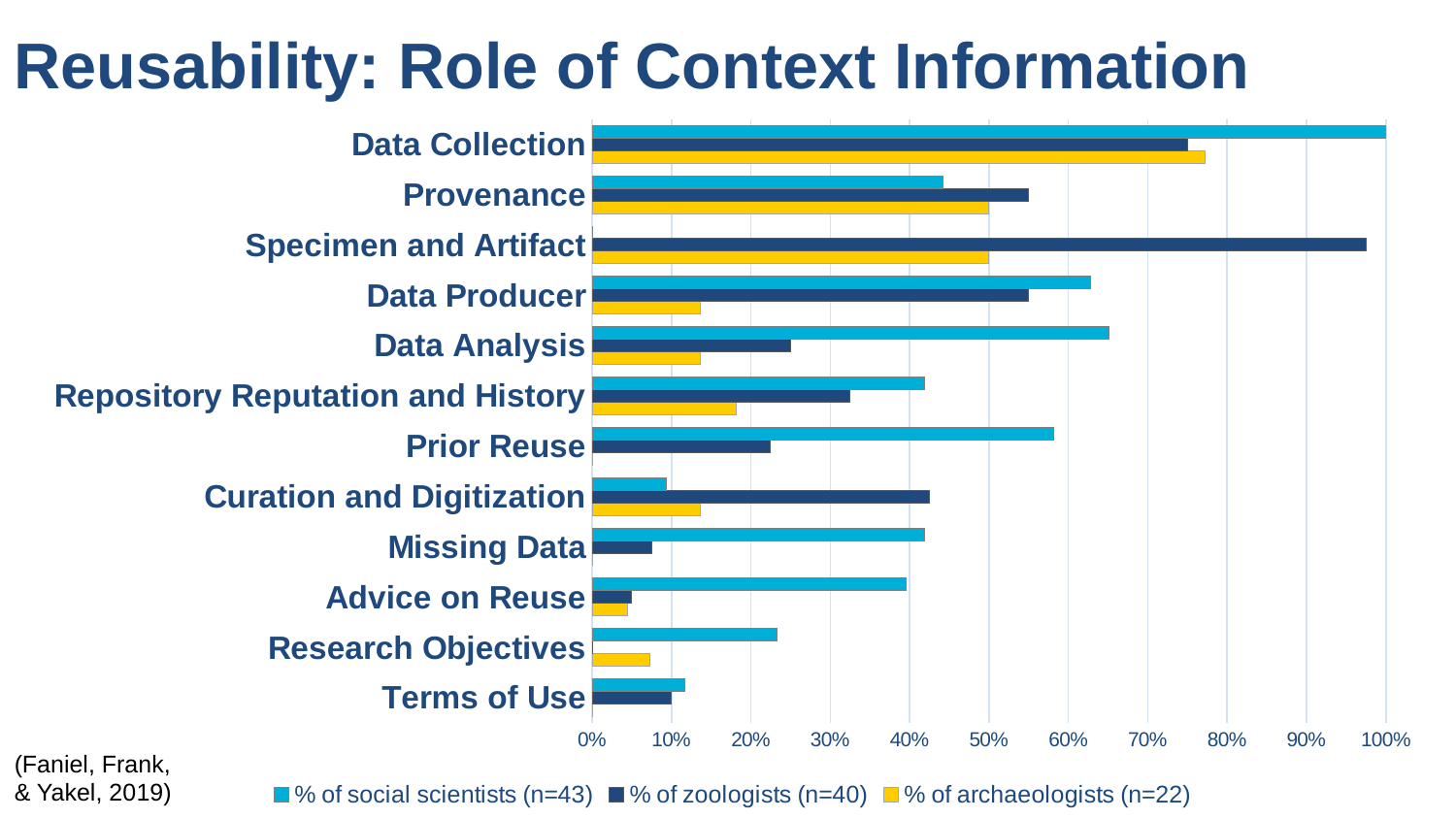
What kind of chart is shown on the slide? bar chart Is the value for Data Analysis for % of zoologists (n=40) greater or less than 30%? less What is the value for Data Collection for % of social scientists (n=43)? 100% What is the title of the slide's chart? Reusability: Role of Context Information How many categories are plotted on the chart? 12 Is the value for Terms of Use for % of social scientists (n=43) greater or less than 20%? less Which category has the highest value for % of social scientists (n=43)? Data Collection How many series does the legend list? 3 For Provenance, which is larger: the value for % of zoologists (n=40) or % of social scientists (n=43)? % of zoologists (n=40) For Curation and Digitization, which series has the largest value? % of zoologists (n=40) Is the value for Specimen and Artifact for % of zoologists (n=40) greater or less than 90%? greater For Prior Reuse, which is larger: the value for % of social scientists (n=43) or % of zoologists (n=40)? % of social scientists (n=43)